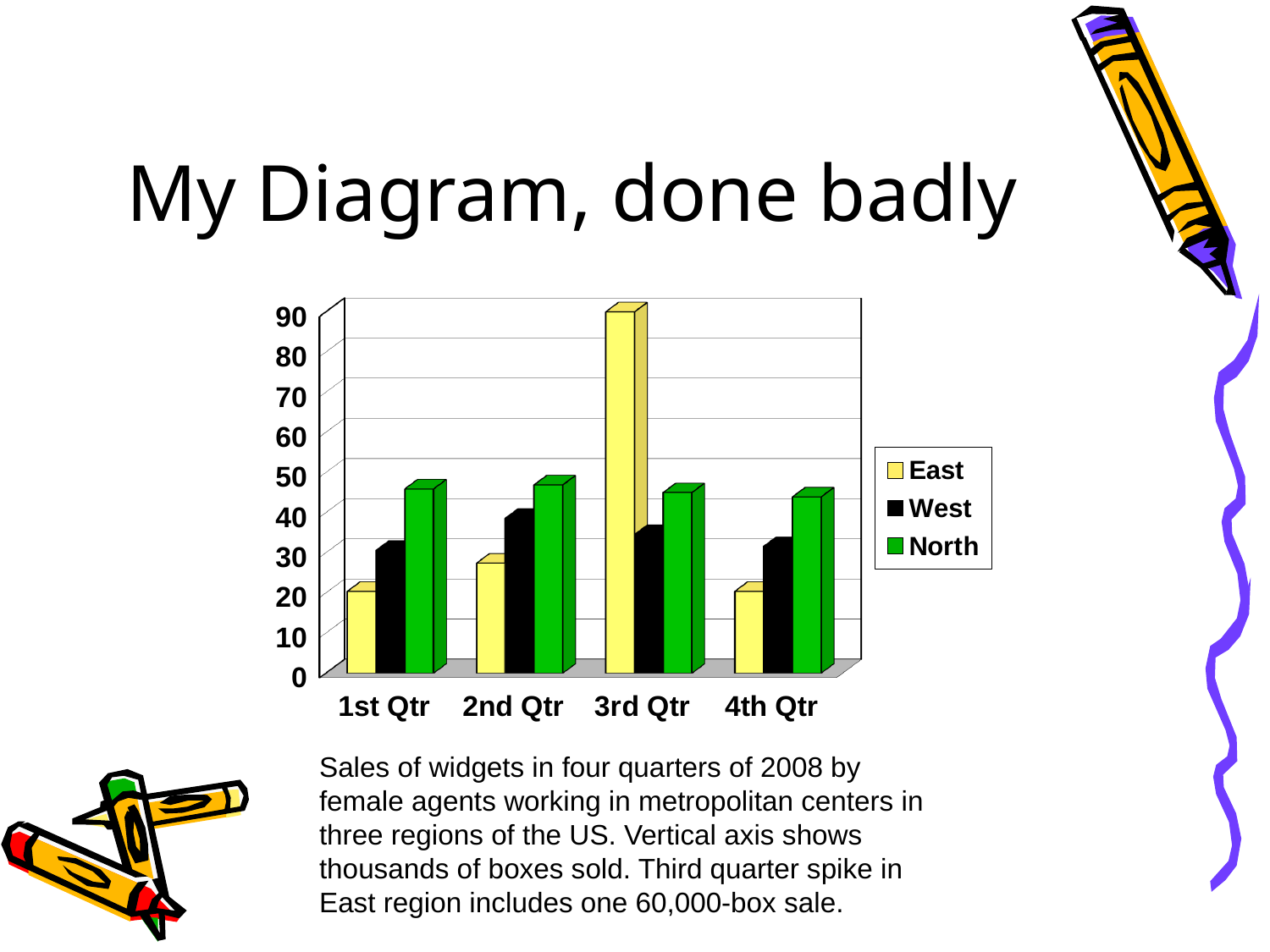
In which quarter is the East value highest? 3rd Qtr What kind of chart is shown on the slide? bar chart Is the value for East in 1st Qtr greater or less than 30? less Which is larger in 3rd Qtr, East or West? East Which series has the highest value in 1st Qtr? North How many quarters are shown on the x axis? 4 Is the value for East in 3rd Qtr greater or less than 80? greater What are the three entries in the legend? East, West, North Is the value for North in 1st Qtr greater or less than 40? greater Which is larger in 2nd Qtr, West or North? North Which series has the lowest value in 1st Qtr? East How many series does the legend list? 3